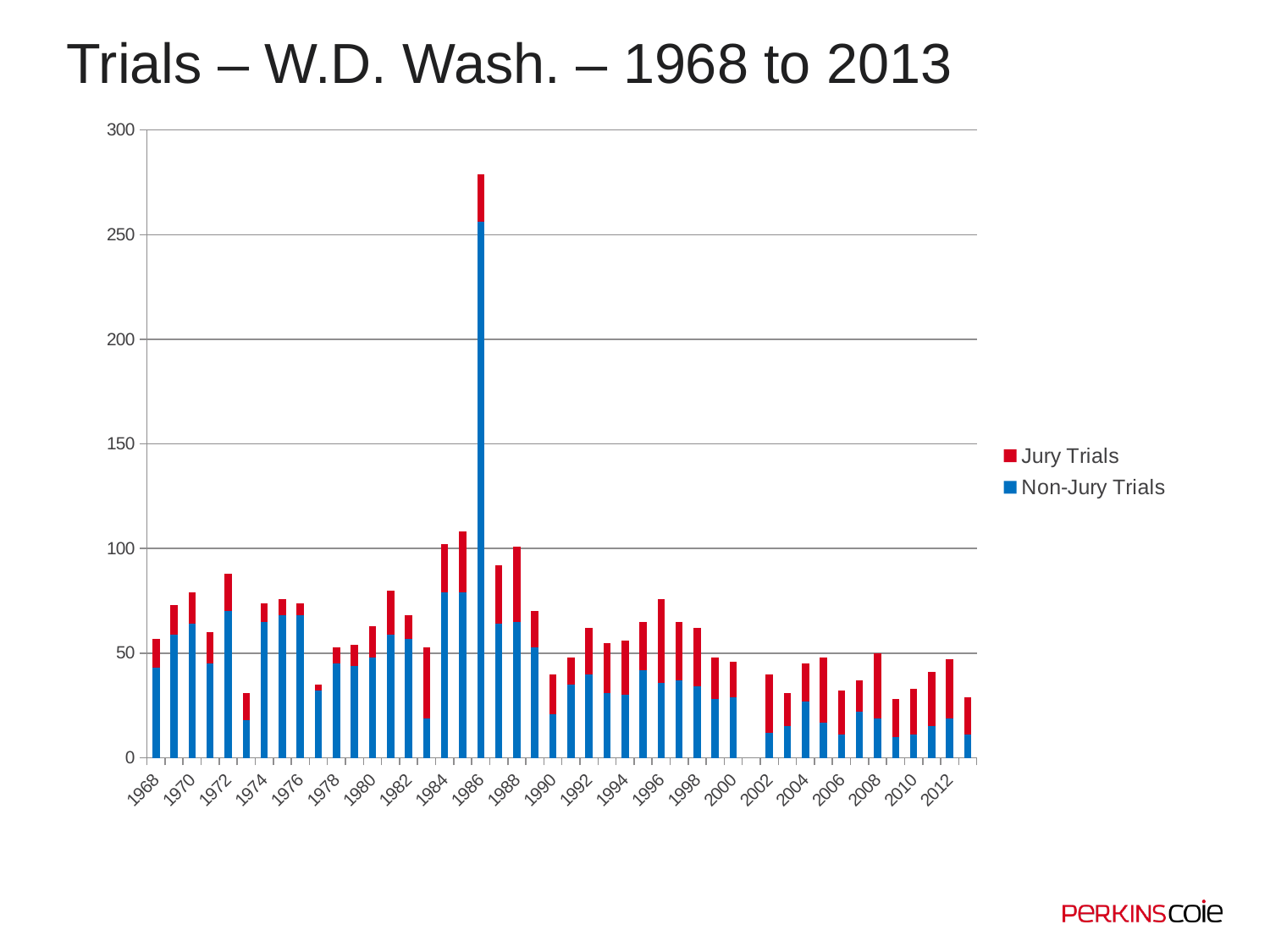
Which year has the larger total number of trials, 1985 or 1986? 1986 Is the total value for 1973 greater or less than 50? less Is the total value for 1987 greater or less than 100? less Is the total value for 1972 greater or less than 50? greater Which colour represents Jury Trials in the legend? Red How many series does the legend list? 2 What kind of chart is shown on the slide? Stacked bar chart Which year has the highest total number of trials? 1986 Which year has the larger total number of trials, 1972 or 1973? 1972 Do the total values rise or fall from 1984 to 1986? rise